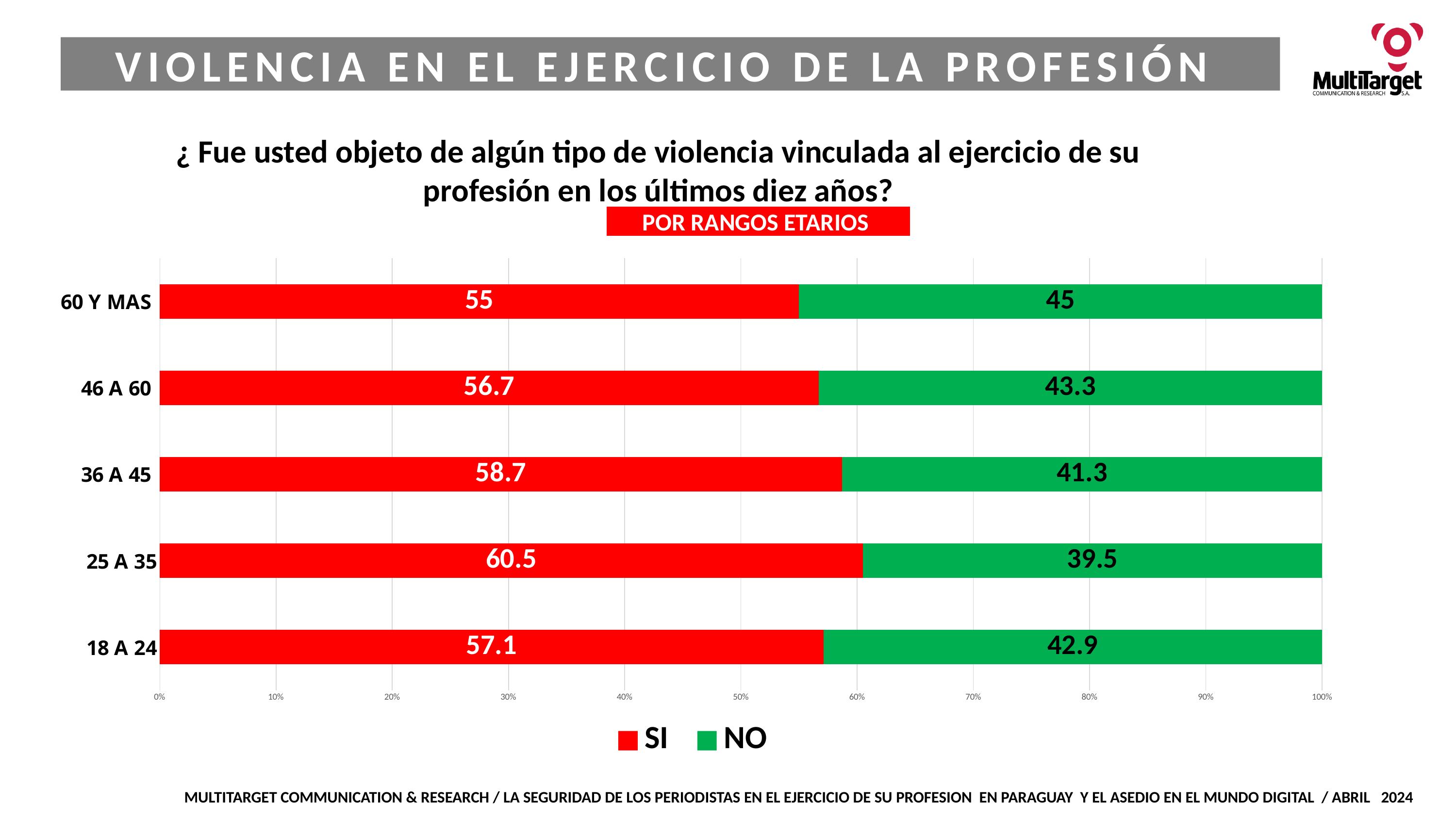
How many age ranges are shown in the chart? 5 How many series does the legend list? 2 What is the total of the stacked bar for the 46 A 60 age range? 100 Which age range has the highest NO value? 60 Y MAS What is the SI value for the 18 A 24 age range? 57.1 Which age range has the highest SI value? 25 A 35 What kind of chart is shown on the slide? Stacked bar chart What is the SI value for the 25 A 35 age range? 60.5 What is the difference between the SI and NO values for the 36 A 45 age range? 17.4 Which age range has the lowest SI value? 60 Y MAS What is the NO value for the 60 Y MAS age range? 45 Which is larger, the SI value for 46 A 60 or the SI value for 18 A 24? 18 A 24